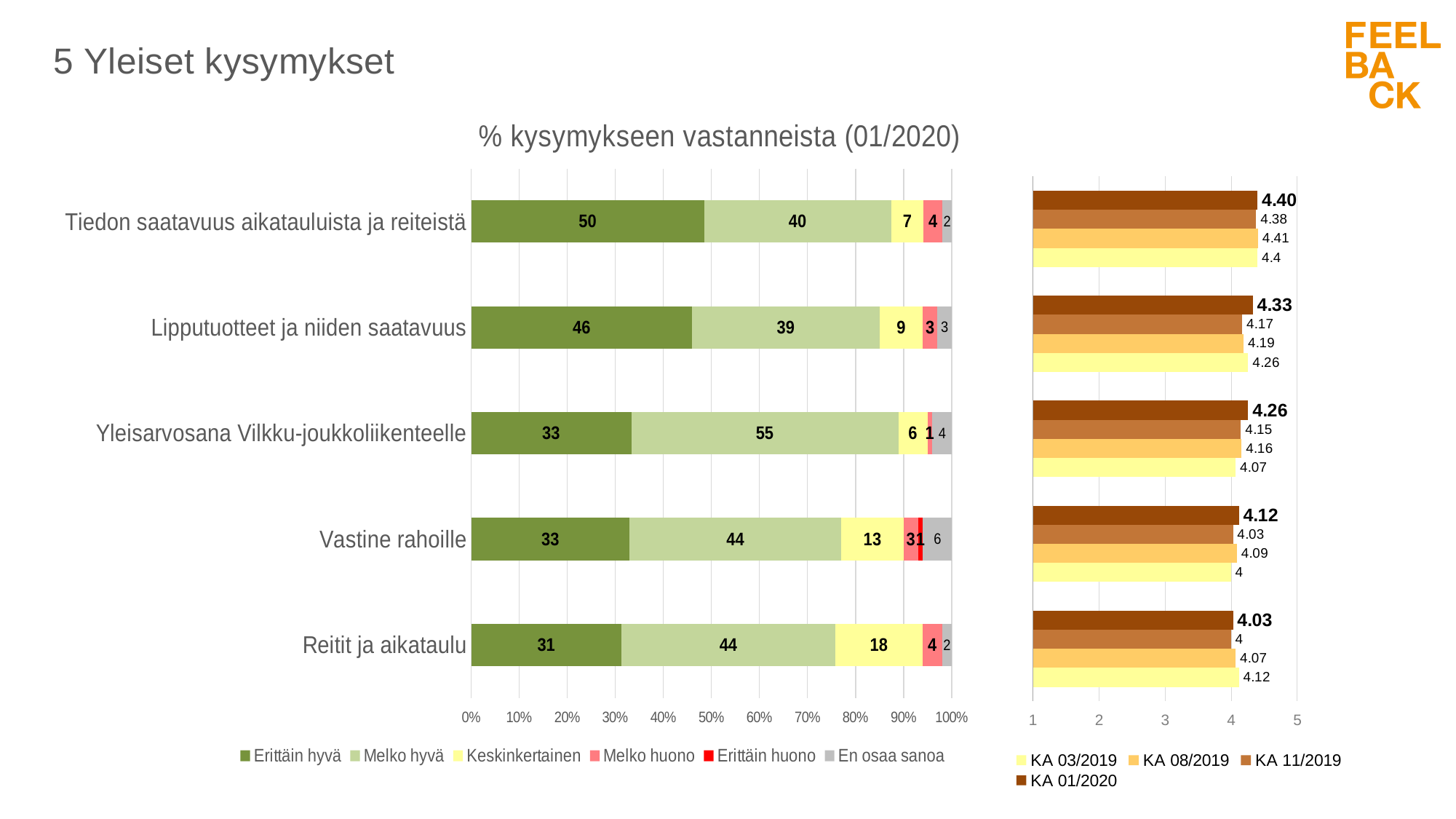
What kind of chart is the left chart '% kysymykseen vastanneista (01/2020)'? Stacked bar chart In the right chart, how many series does the legend list? 4 In the right chart, what is the KA 01/2020 value for 'Lipputuotteet ja niiden saatavuus'? 4.33 In the left chart '% kysymykseen vastanneista (01/2020)', what is the difference between the 'Melko hyvä' values for 'Yleisarvosana Vilkku-joukkoliikenteelle' and 'Vastine rahoille'? 11 In the right chart, which category has the highest KA 01/2020 value? Tiedon saatavuus aikatauluista ja reiteistä In the left chart '% kysymykseen vastanneista (01/2020)', how many series does the legend list? 6 In the left chart '% kysymykseen vastanneista (01/2020)', what is the 'Melko hyvä' value for 'Yleisarvosana Vilkku-joukkoliikenteelle'? 55 In the left chart '% kysymykseen vastanneista (01/2020)', how many categories are shown? 5 In the left chart '% kysymykseen vastanneista (01/2020)', what is the 'Keskinkertainen' value for 'Reitit ja aikataulu'? 18 In the left chart '% kysymykseen vastanneista (01/2020)', what is the 'Erittäin hyvä' value for 'Tiedon saatavuus aikatauluista ja reiteistä'? 50 In the left chart '% kysymykseen vastanneista (01/2020)', which category has the highest 'Erittäin hyvä' value? Tiedon saatavuus aikatauluista ja reiteistä In the right chart, what is the KA 03/2019 value for 'Reitit ja aikataulu'? 4.12